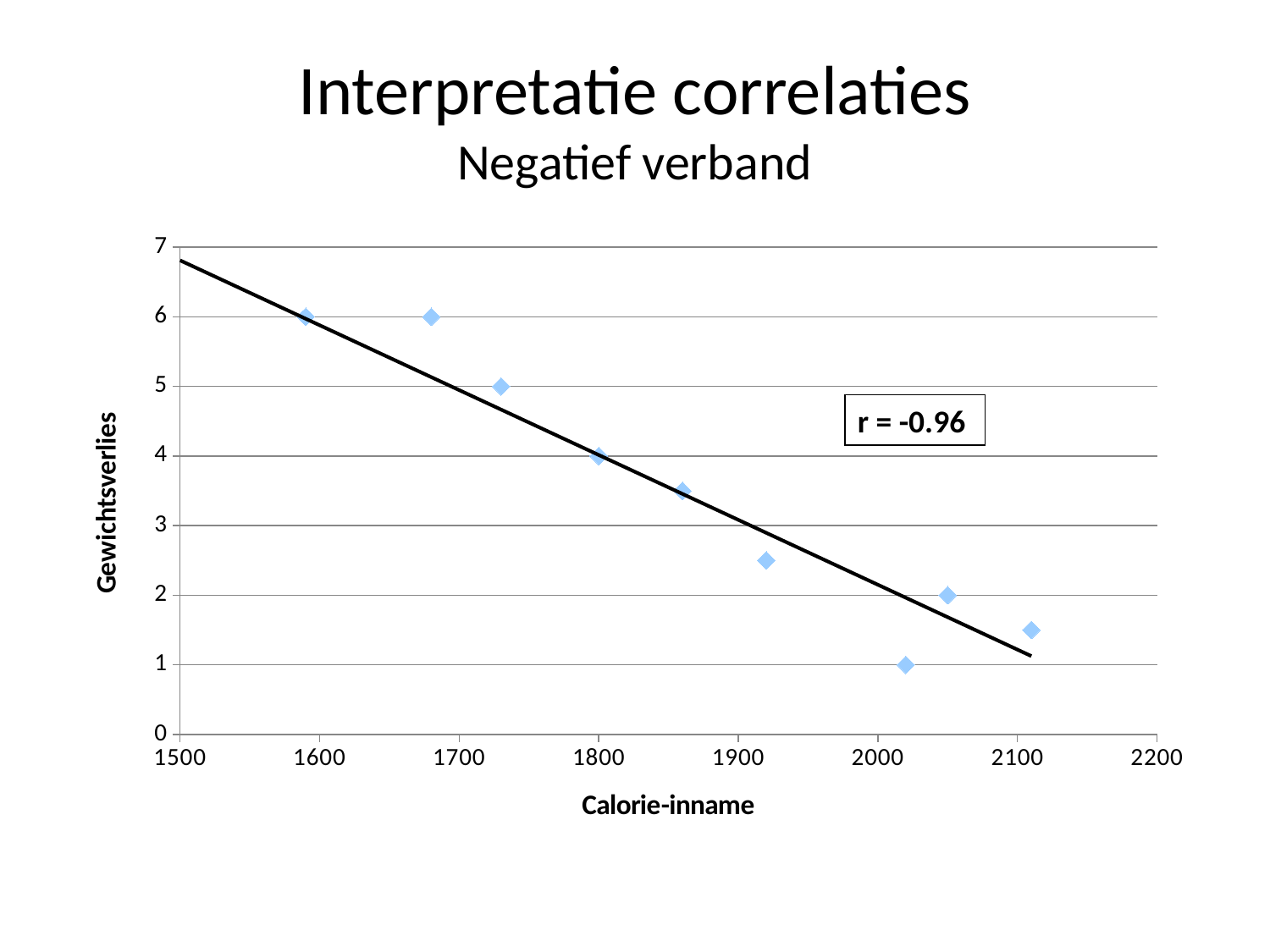
How many points have a Calorie-inname above 2000? 3 Do the values of Gewichtsverlies rise or fall as Calorie-inname increases along the x axis? fall Is the trend line's value at a Calorie-inname of 1500 greater or less than 6? greater Is the Gewichtsverlies value of the point with the highest Calorie-inname greater or less than 2? less How many points have a Gewichtsverlies value above 5? 2 Which has the higher Gewichtsverlies value, the leftmost point or the rightmost point? the leftmost point Is the Gewichtsverlies value of the point with the lowest Calorie-inname greater or less than 5? greater What correlation coefficient is shown in the box on the chart? r = -0.96 What kind of chart is shown on the slide? scatter plot How many data points are plotted in the chart? 9 What is the title of the x axis of the chart? Calorie-inname